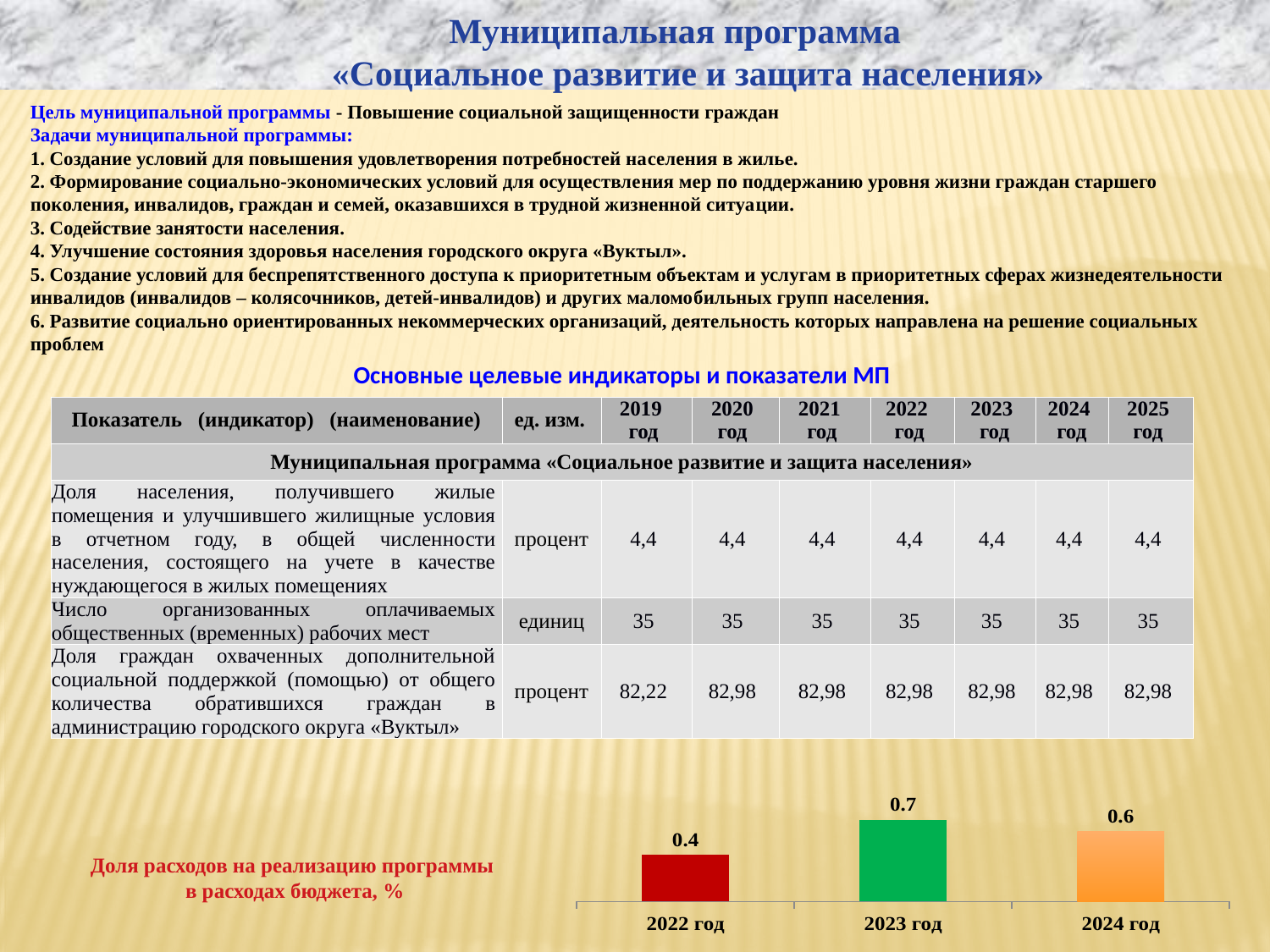
In the chart 'Доля расходов на реализацию программы в расходах бюджета, %', which is larger: the value for 2024 год or the value for 2022 год? 2024 год What kind of chart is 'Доля расходов на реализацию программы в расходах бюджета, %'? bar chart What colour is the bar for 2023 год in the chart 'Доля расходов на реализацию программы в расходах бюджета, %'? green What is the value for 2024 год in the chart 'Доля расходов на реализацию программы в расходах бюджета, %'? 0.6 In the chart 'Доля расходов на реализацию программы в расходах бюджета, %', what is the difference between the values for 2023 год and 2022 год? 0.3 In the chart 'Доля расходов на реализацию программы в расходах бюджета, %', what is the difference between the values for 2023 год and 2024 год? 0.1 What is the value for 2022 год in the chart 'Доля расходов на реализацию программы в расходах бюджета, %'? 0.4 In the chart 'Доля расходов на реализацию программы в расходах бюджета, %', does the value rise or fall from 2022 год to 2023 год? rise How many years (bars) are shown in the chart 'Доля расходов на реализацию программы в расходах бюджета, %'? 3 What is the value for 2023 год in the chart 'Доля расходов на реализацию программы в расходах бюджета, %'? 0.7 Which year has the lowest value in the chart 'Доля расходов на реализацию программы в расходах бюджета, %'? 2022 год Which year has the highest value in the chart 'Доля расходов на реализацию программы в расходах бюджета, %'? 2023 год